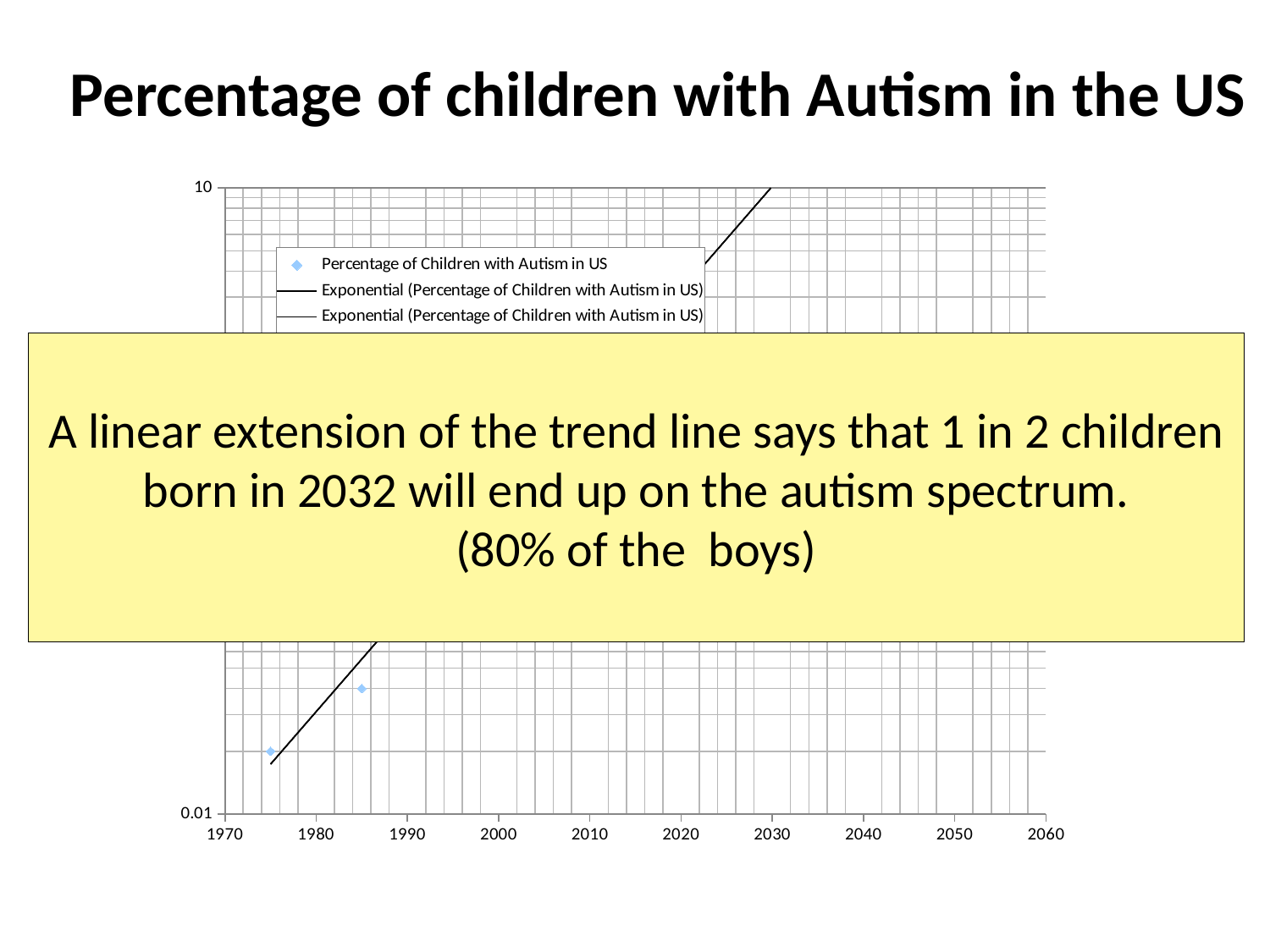
Is the value of the plotted point near 1975 greater or less than 10? less What kind of chart is shown on the slide? scatter chart What is the last year labelled on the chart's x axis? 2060 What is the first year labelled on the chart's x axis? 1970 Is the value of the plotted point near 1985 greater or less than 0.01? greater How many entries does the chart's legend list? 3 What is the highest value labelled on the chart's y axis? 10 Does the trend line on the chart rise or fall as the years increase? rise What is the title of the chart on the slide? Percentage of children with Autism in the US What is the lowest value labelled on the chart's y axis? 0.01 What is the first entry listed in the chart's legend? Percentage of Children with Autism in US Which plotted point is higher, the one near 1975 or the one near 1985? the one near 1985